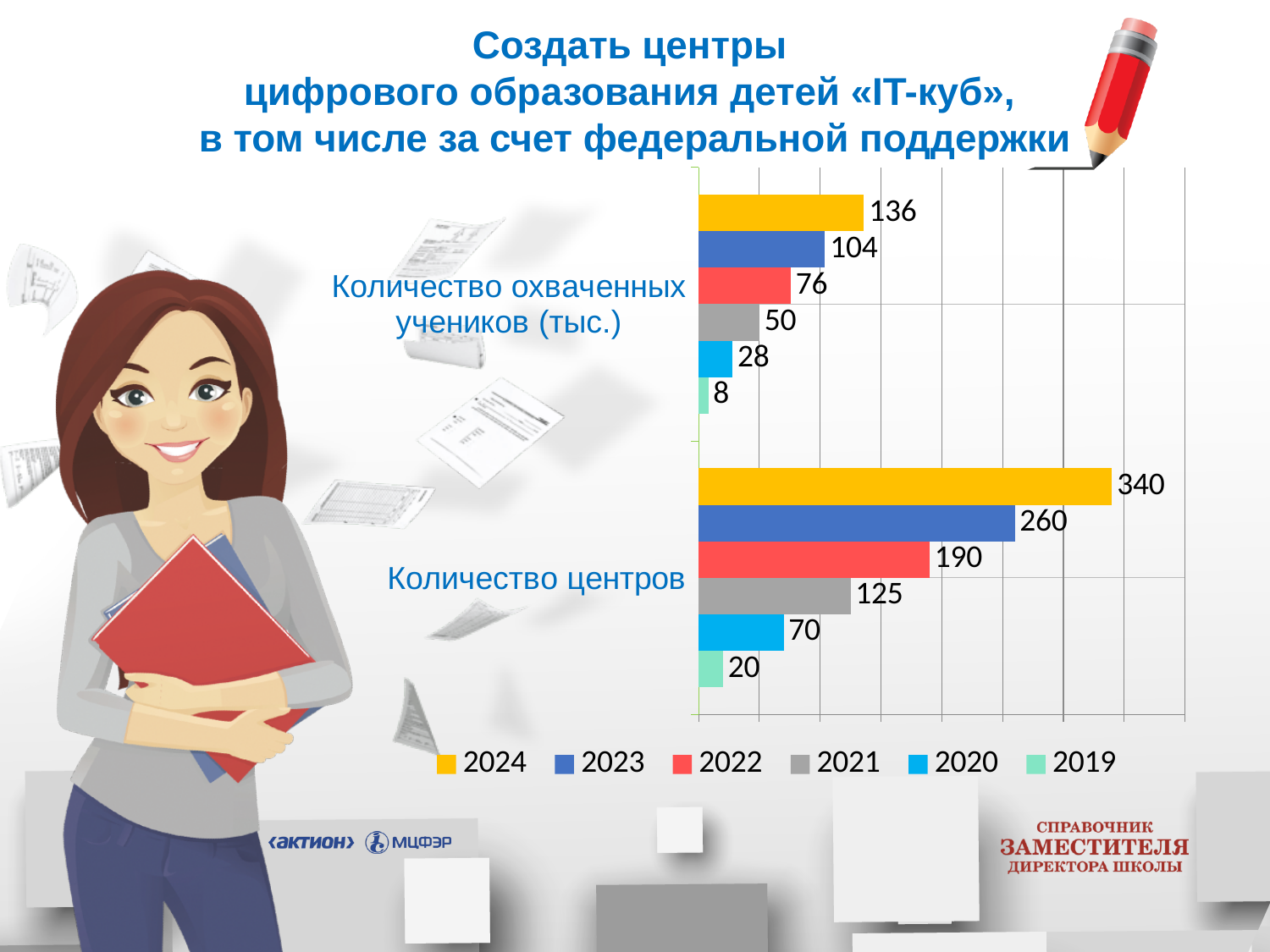
What is the value for 2019 in the "Количество охваченных учеников (тыс.)" category? 8 What is the value for 2022 in the "Количество охваченных учеников (тыс.)" category? 76 Which colour represents 2022 in the legend? Red Which is larger in the "Количество центров" category: the value for 2020 or the value for 2021? 2021 What is the value for 2021 in the "Количество центров" category? 125 What is the difference between the 2024 and 2023 values in the "Количество центров" category? 80 What is the difference between the 2023 and 2022 values in the "Количество охваченных учеников (тыс.)" category? 28 What is the value for 2024 in the "Количество центров" category? 340 What kind of chart is shown on the slide? Bar chart Which year has the highest value in the "Количество центров" category? 2024 How many series does the legend list? 6 Which year has the lowest value in the "Количество охваченных учеников (тыс.)" category? 2019